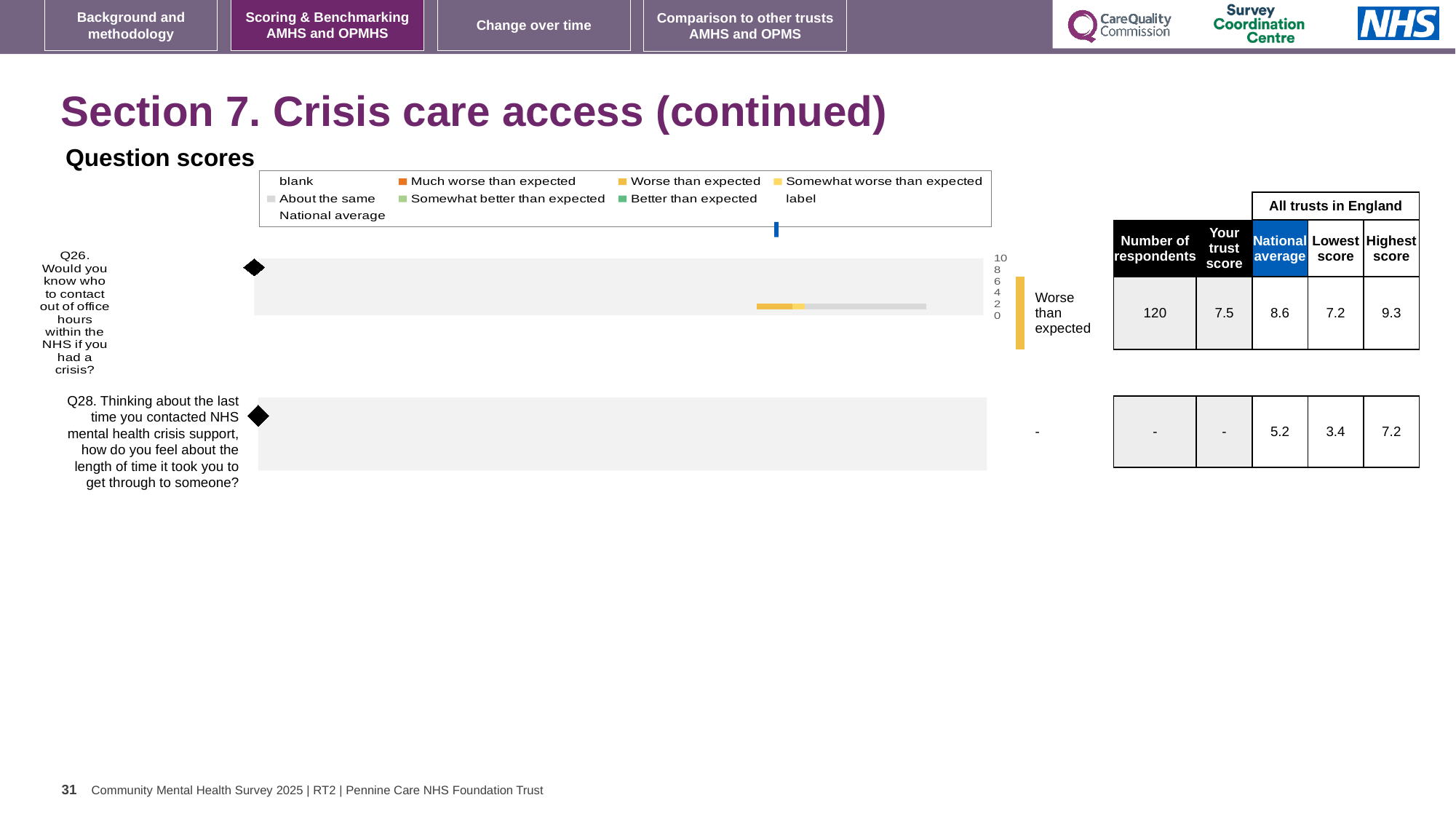
What kind of chart is used to show the question scores on this slide? bar chart What is the national average score for Q28? 5.2 What is the difference between the national average and the trust score for Q26? 1.1 What is the trust score for Q26 (Would you know who to contact out of office hours within the NHS if you had a crisis?)? 7.5 How many respondents answered Q26? 120 What is the highest score among all trusts in England for Q26? 9.3 What colour is used in the legend for 'Much worse than expected'? orange Which is larger for Q26: the trust score or the national average? national average What benchmark category is shown for Q26? Worse than expected What is the lowest score among all trusts in England for Q28? 3.4 What is the national average score for Q26? 8.6 How many questions are plotted in the question scores chart? 2